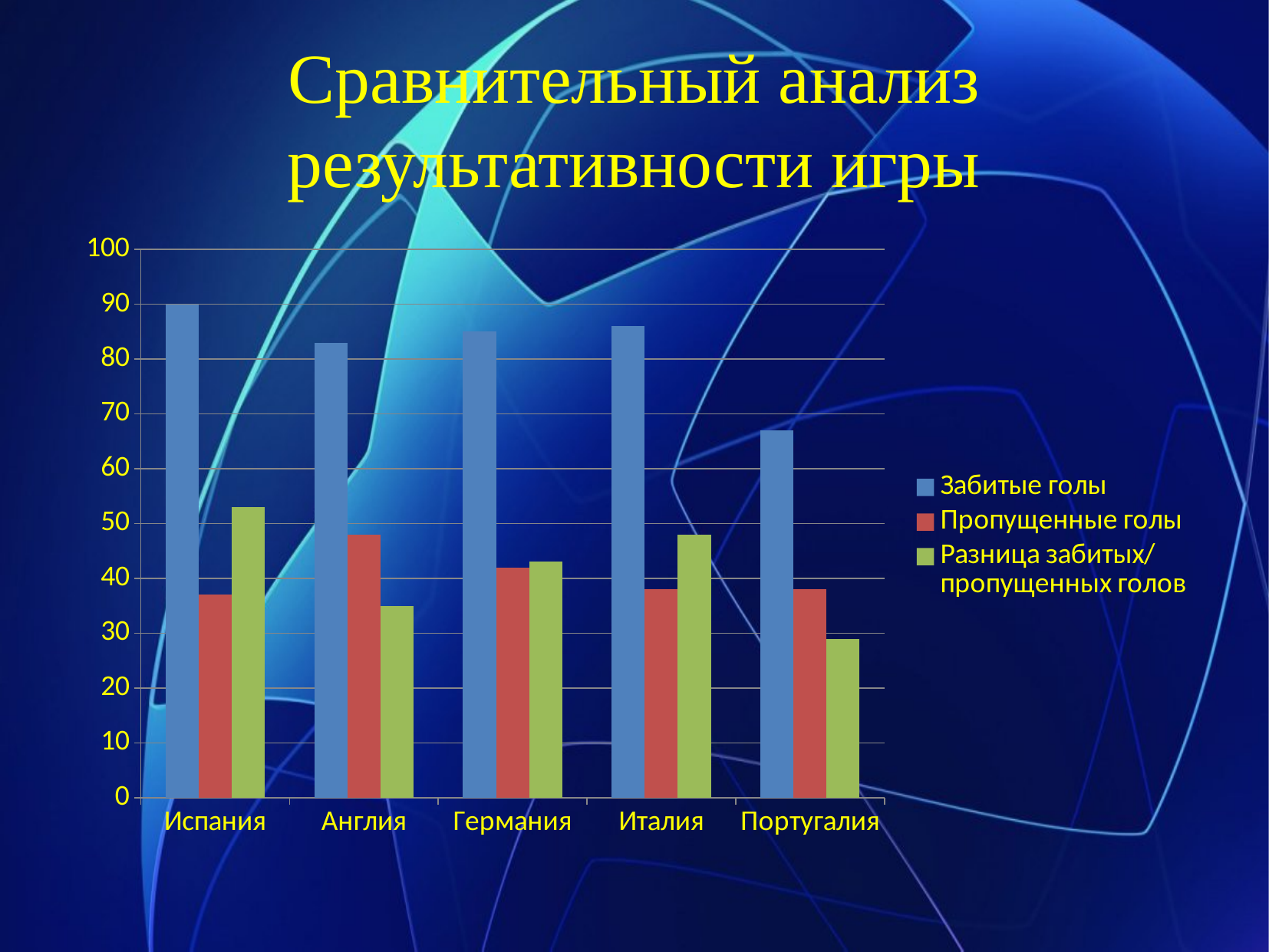
Which country has the highest value for Пропущенные голы? Англия Is the value of Забитые голы for Германия greater or less than 80? greater Is the value of Разница забитых/пропущенных голов for Португалия greater or less than 40? less What kind of chart is shown on the slide? bar chart How many countries are shown on the x axis of the chart? 5 Which country has the highest value for Разница забитых/пропущенных голов? Испания Which country has the lowest value for Разница забитых/пропущенных голов? Португалия How many series does the chart's legend list? 3 What is the title of the slide containing the chart? Сравнительный анализ результативности игры Which is larger: Разница забитых/пропущенных голов for Испания or for Англия? Испания Is the value of Забитые голы for Португалия greater or less than 70? less Which country has the lowest value for Забитые голы? Португалия